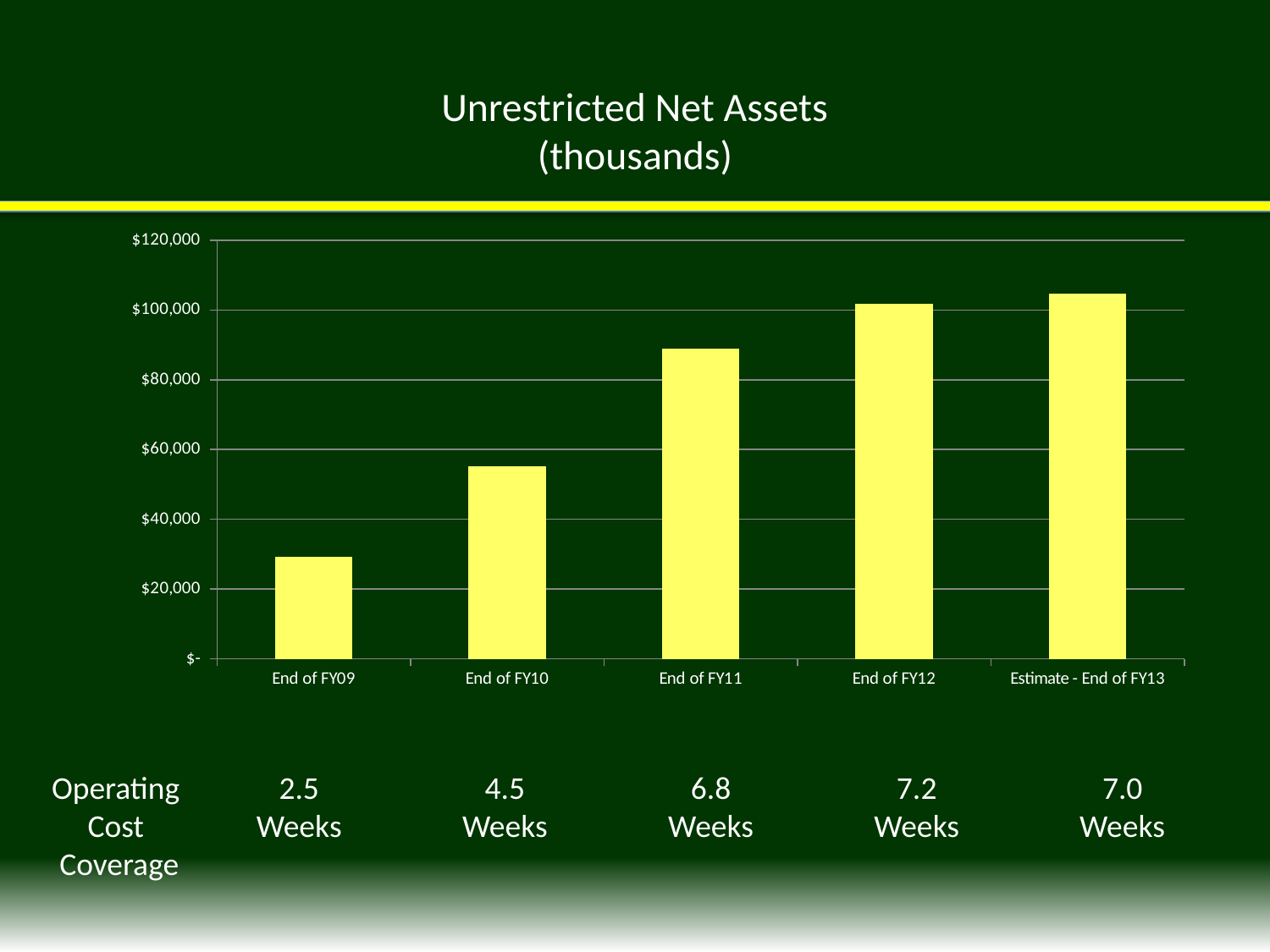
Which category has the lowest unrestricted net assets? End of FY09 Do the values rise or fall from End of FY09 to Estimate - End of FY13? rise What is the title of the chart? Unrestricted Net Assets (thousands) What kind of chart is shown on the slide? bar chart Is the value for End of FY09 greater or less than $40,000? less Which is larger, the value for End of FY10 or the value for End of FY11? End of FY11 What colour are the bars in the chart? yellow Is the value for Estimate - End of FY13 greater or less than $120,000? less Is the value for End of FY10 greater or less than $40,000? greater How many categories are plotted on the x axis of the chart? 5